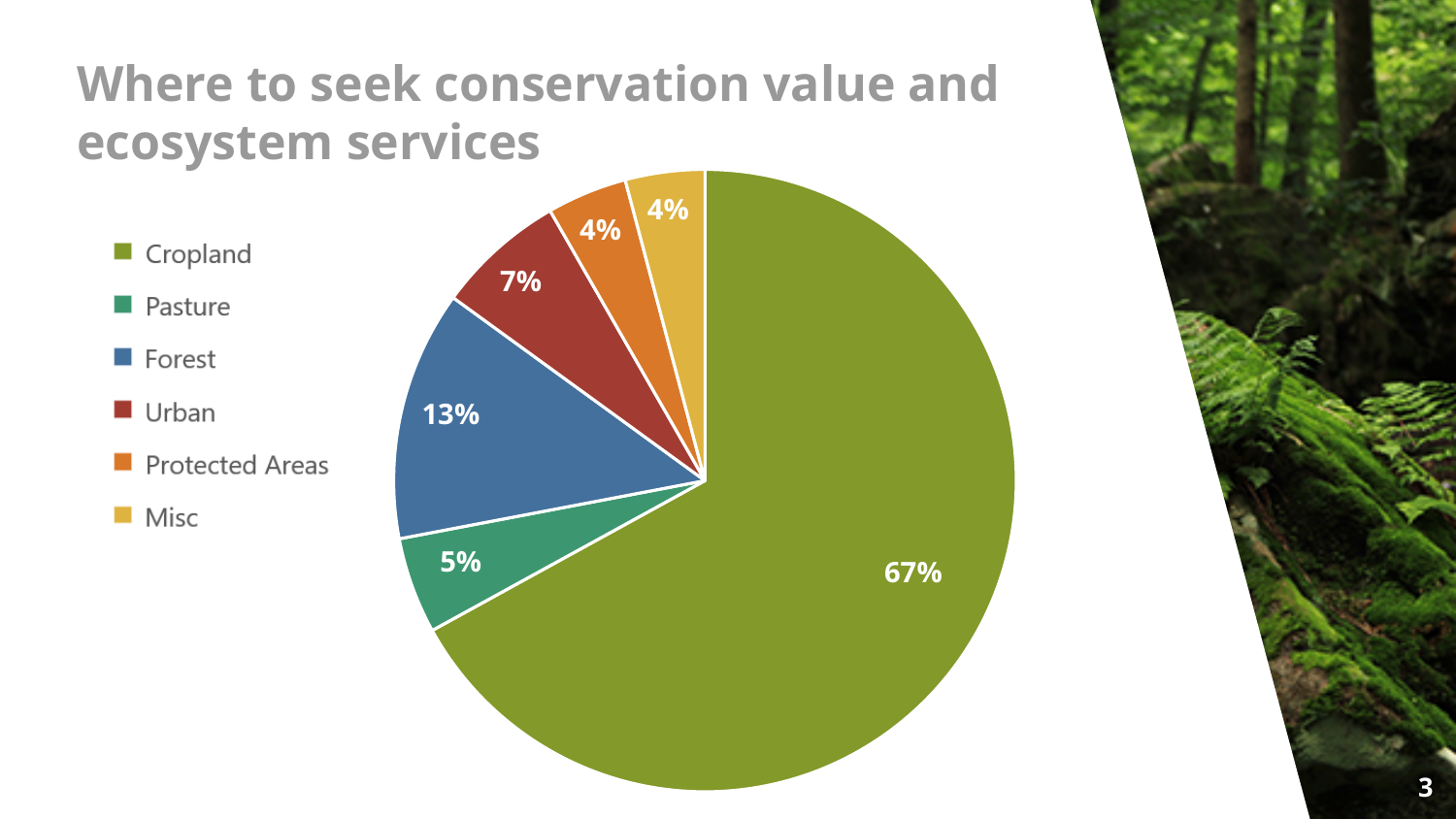
What kind of chart is shown on the slide? Pie chart What is the value shown for Forest? 13% What is the combined share of Protected Areas and Misc? 8% What is the value shown for Pasture? 5% What is the difference between the Cropland and Forest shares? 54% What share of the pie does Cropland represent? 67% Which legend entry is shown in blue? Forest Which category has the largest slice of the pie? Cropland What is the value shown for Urban? 7% What is the difference between the Forest and Pasture shares? 8% How many categories does the pie chart show? 6 Which is larger, the Urban share or the Pasture share? Urban